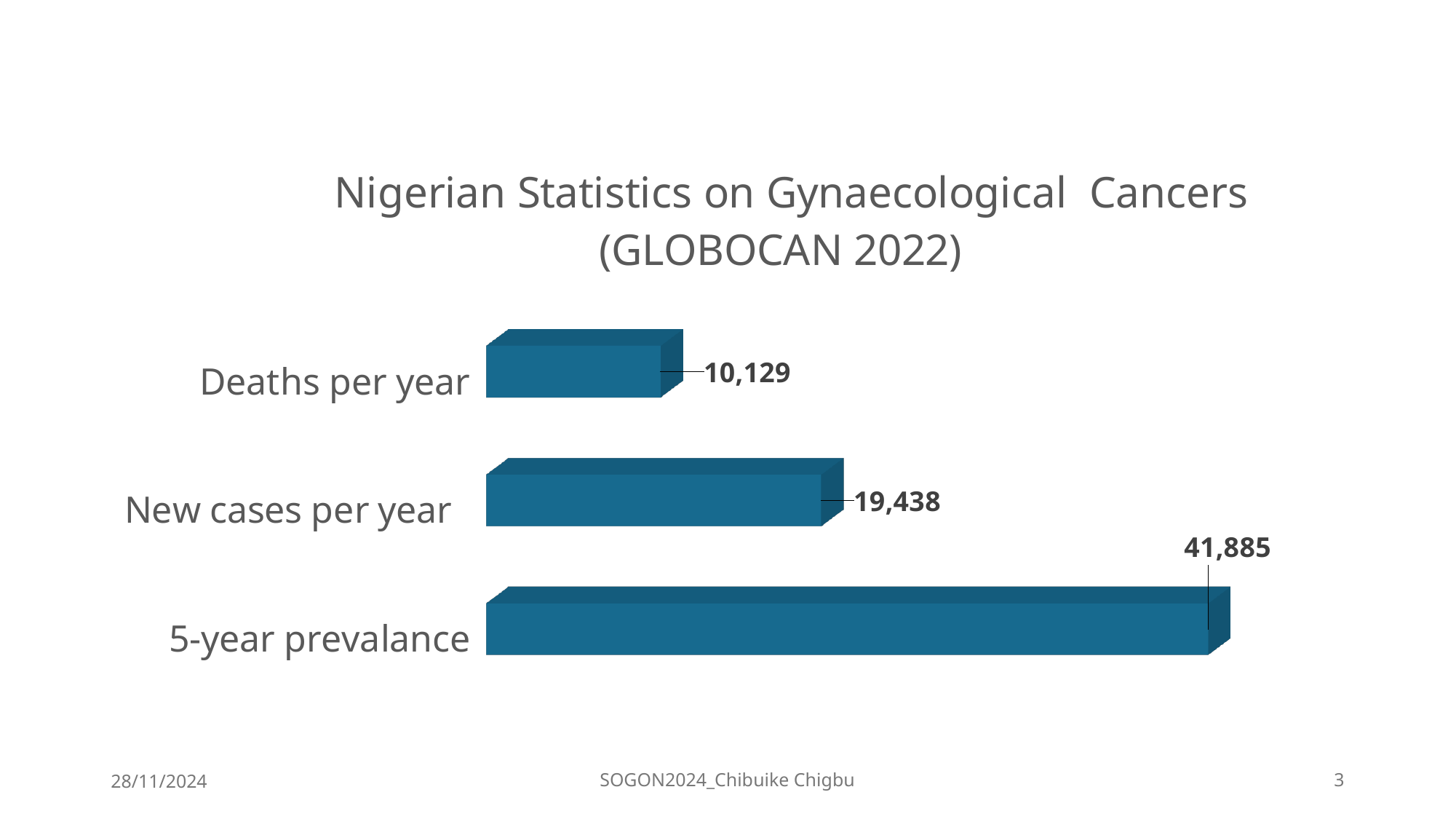
What is the value for Deaths per year? 10,129 What kind of chart is shown on the slide? Bar chart What colour are the bars in the chart? Blue How many categories are shown in the chart? 3 Which is larger, New cases per year or Deaths per year? New cases per year What is the value for New cases per year? 19,438 Which category has the highest value? 5-year prevalance What is the difference between 5-year prevalance and New cases per year? 22,447 What is the title of the chart? Nigerian Statistics on Gynaecological Cancers (GLOBOCAN 2022) What is the value for 5-year prevalance? 41,885 Which category has the lowest value? Deaths per year What is the difference between New cases per year and Deaths per year? 9,309